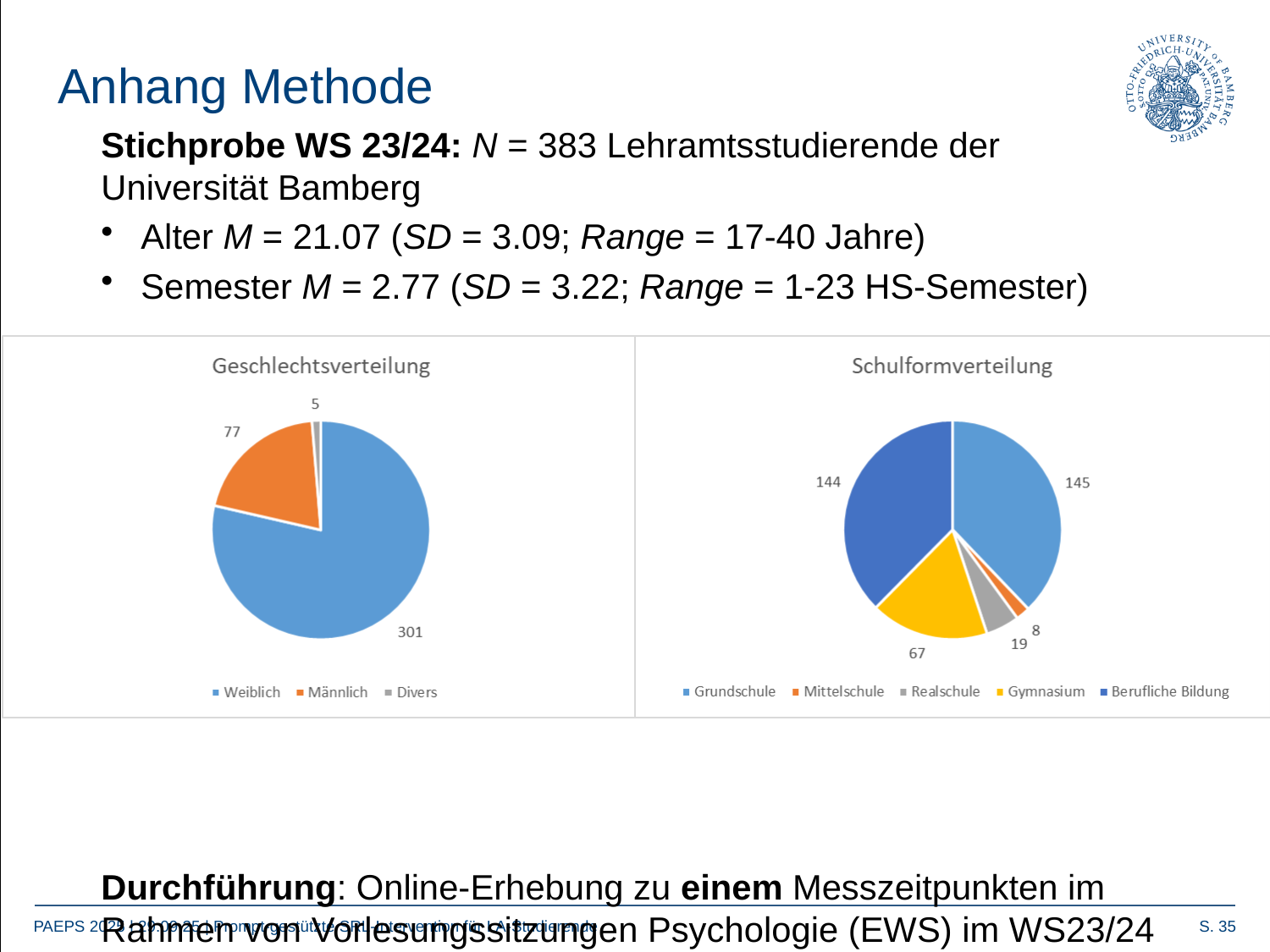
In the Geschlechtsverteilung chart, what is the difference between Weiblich and Männlich? 224 What type of chart is the Schulformverteilung chart? Pie chart In the Schulformverteilung chart, which is larger, Gymnasium or Realschule? Gymnasium In the Schulformverteilung chart, what is the value for Realschule? 19 In the Geschlechtsverteilung chart, how many categories does the legend list? 3 In the Schulformverteilung chart, which category has the lowest value? Mittelschule In the Geschlechtsverteilung chart, which category has the lowest value? Divers In the Geschlechtsverteilung chart, what is the value for Weiblich? 301 In the Geschlechtsverteilung chart, what is the value for Männlich? 77 In the Schulformverteilung chart, how many categories does the legend list? 5 In the Schulformverteilung chart, what is the value for Gymnasium? 67 In the Schulformverteilung chart, what is the difference between Grundschule and Berufliche Bildung? 1